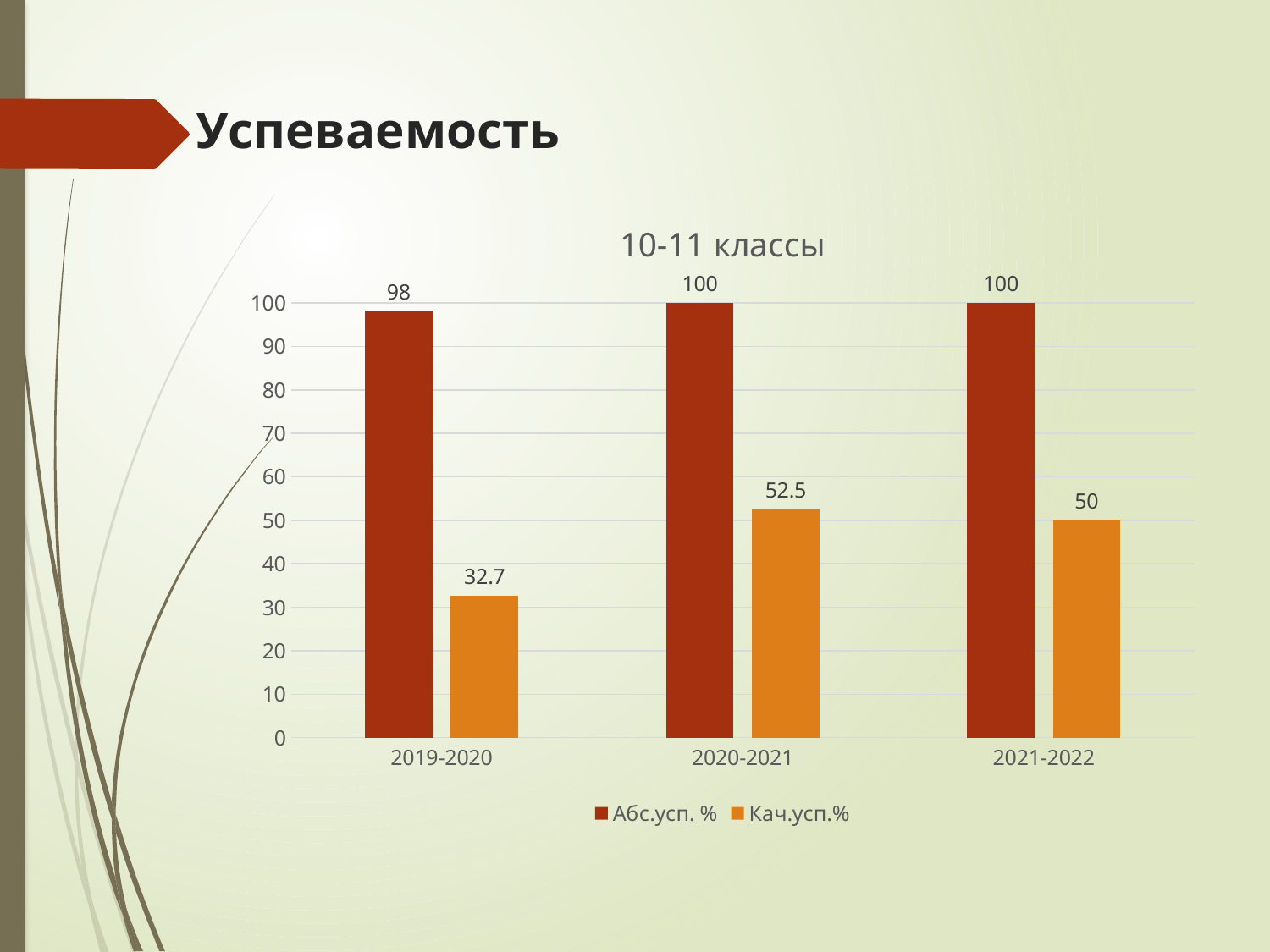
What is the difference between Абс.усп. % and Кач.усп.% in 2021-2022? 50 Which is larger: Кач.усп.% in 2020-2021 or in 2021-2022? 2020-2021 How many series does the legend list? 2 What is the value of Кач.усп.% for 2020-2021? 52.5 What is the value of Абс.усп. % for 2019-2020? 98 What type of chart is shown on the slide? Bar chart What is the difference between Кач.усп.% in 2020-2021 and 2019-2020? 19.8 What is the title of the chart? 10-11 классы What is the value of Кач.усп.% for 2021-2022? 50 Which year has the lowest Кач.усп.% value? 2019-2020 Which year has the highest Кач.усп.% value? 2020-2021 How many year categories are shown on the x axis? 3